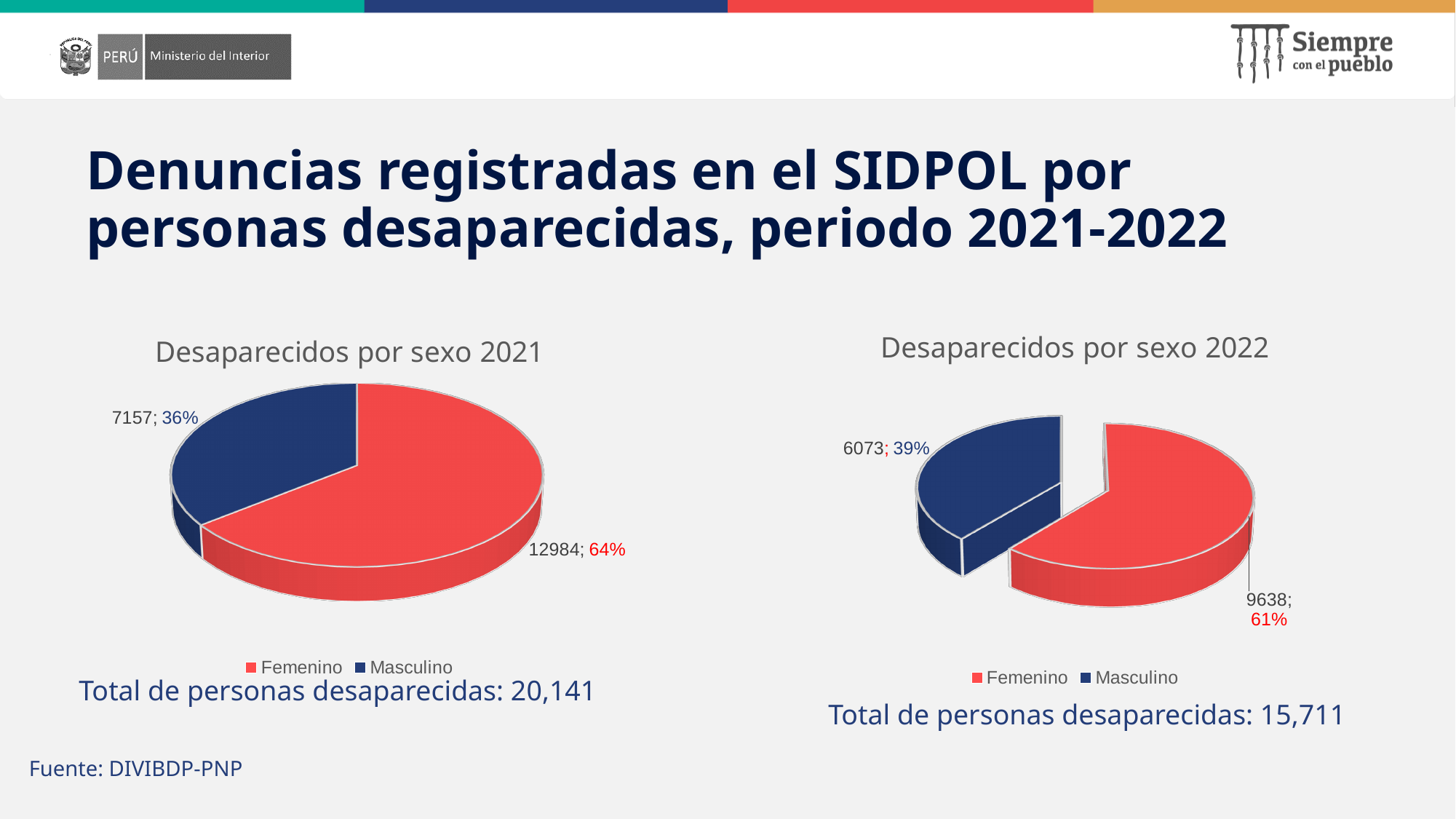
What kind of chart is 'Desaparecidos por sexo 2022'? pie chart In the 'Desaparecidos por sexo 2022' chart, what share of the pie does Femenino represent? 61% In the 'Desaparecidos por sexo 2021' chart, which category is the smallest? Masculino In the 'Desaparecidos por sexo 2022' chart, what is the value for Femenino? 9638 In the 'Desaparecidos por sexo 2021' chart, what is the value for Masculino? 7157 In the 'Desaparecidos por sexo 2021' chart, what is the value for Femenino? 12984 In the 'Desaparecidos por sexo 2022' chart, which category is the largest? Femenino In the 'Desaparecidos por sexo 2021' chart, what share of the pie does Masculino represent? 36% How many categories does the legend of the 'Desaparecidos por sexo 2021' chart list? 2 In the 'Desaparecidos por sexo 2021' chart, what is the difference between the Femenino and Masculino values? 5827 Is the Femenino value in the 'Desaparecidos por sexo 2021' chart larger or smaller than the Femenino value in the 'Desaparecidos por sexo 2022' chart? larger In the 'Desaparecidos por sexo 2022' chart, what is the value for Masculino? 6073